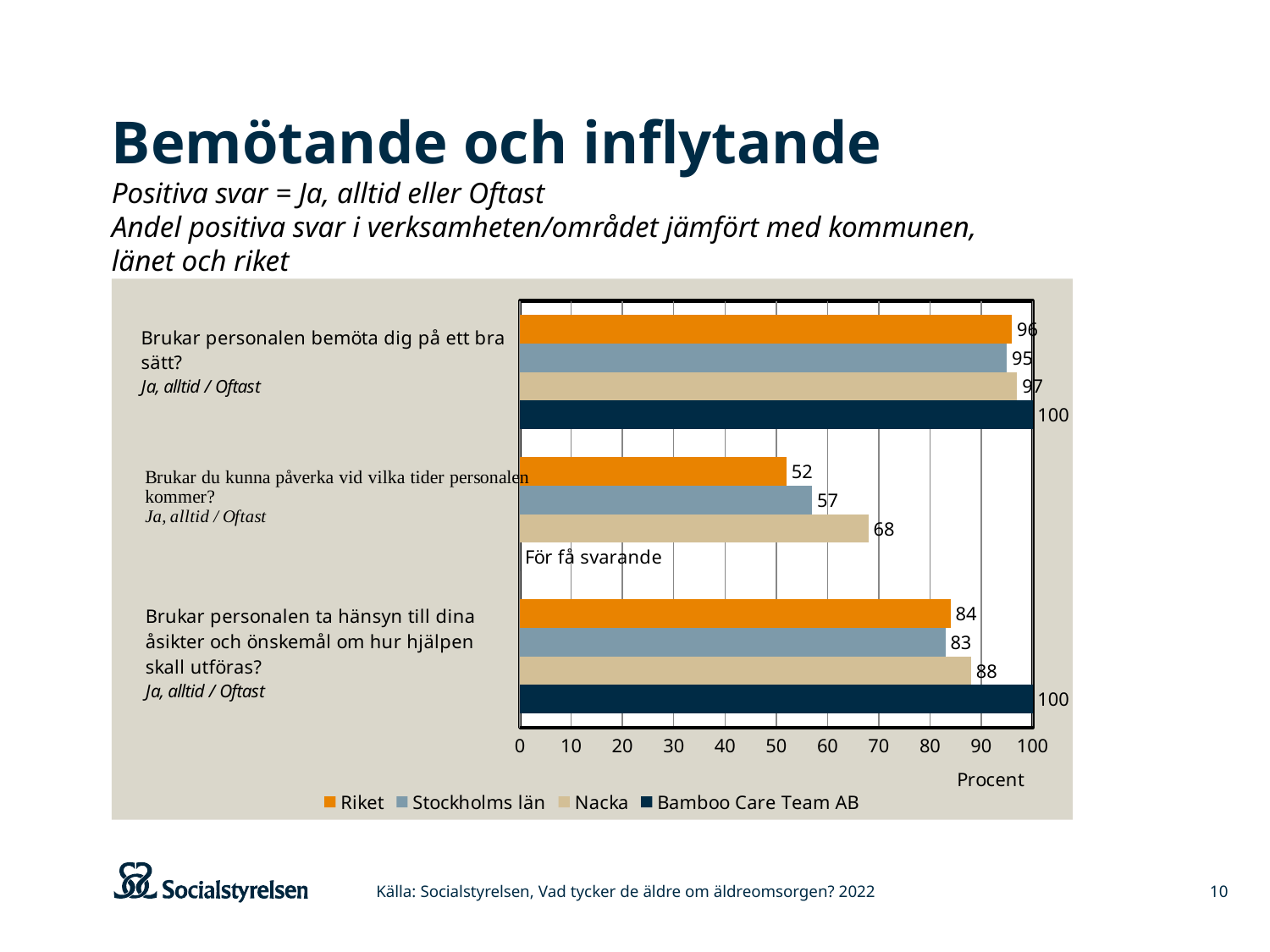
What label is shown on the horizontal axis of the chart? Procent Which is larger on the question "Brukar personalen ta hänsyn till dina åsikter och önskemål om hur hjälpen skall utföras?": Nacka or Stockholms län? Nacka What is the value for Bamboo Care Team AB on the question "Brukar personalen ta hänsyn till dina åsikter och önskemål om hur hjälpen skall utföras?" 100 What is the difference between Nacka and Riket on the question "Brukar du kunna påverka vid vilka tider personalen kommer?" 16 What is shown for Bamboo Care Team AB on the question "Brukar du kunna påverka vid vilka tider personalen kommer?" För få svarande Which series has the lowest value on the question "Brukar du kunna påverka vid vilka tider personalen kommer?" Riket Which series has the highest value on the question "Brukar personalen ta hänsyn till dina åsikter och önskemål om hur hjälpen skall utföras?" Bamboo Care Team AB What type of chart is shown on the slide? Bar chart How many series does the legend list? 4 What is the value for Nacka on the question "Brukar du kunna påverka vid vilka tider personalen kommer?" 68 What is the value for Riket on the question "Brukar personalen bemöta dig på ett bra sätt?" 96 How many question categories are shown on the chart? 3